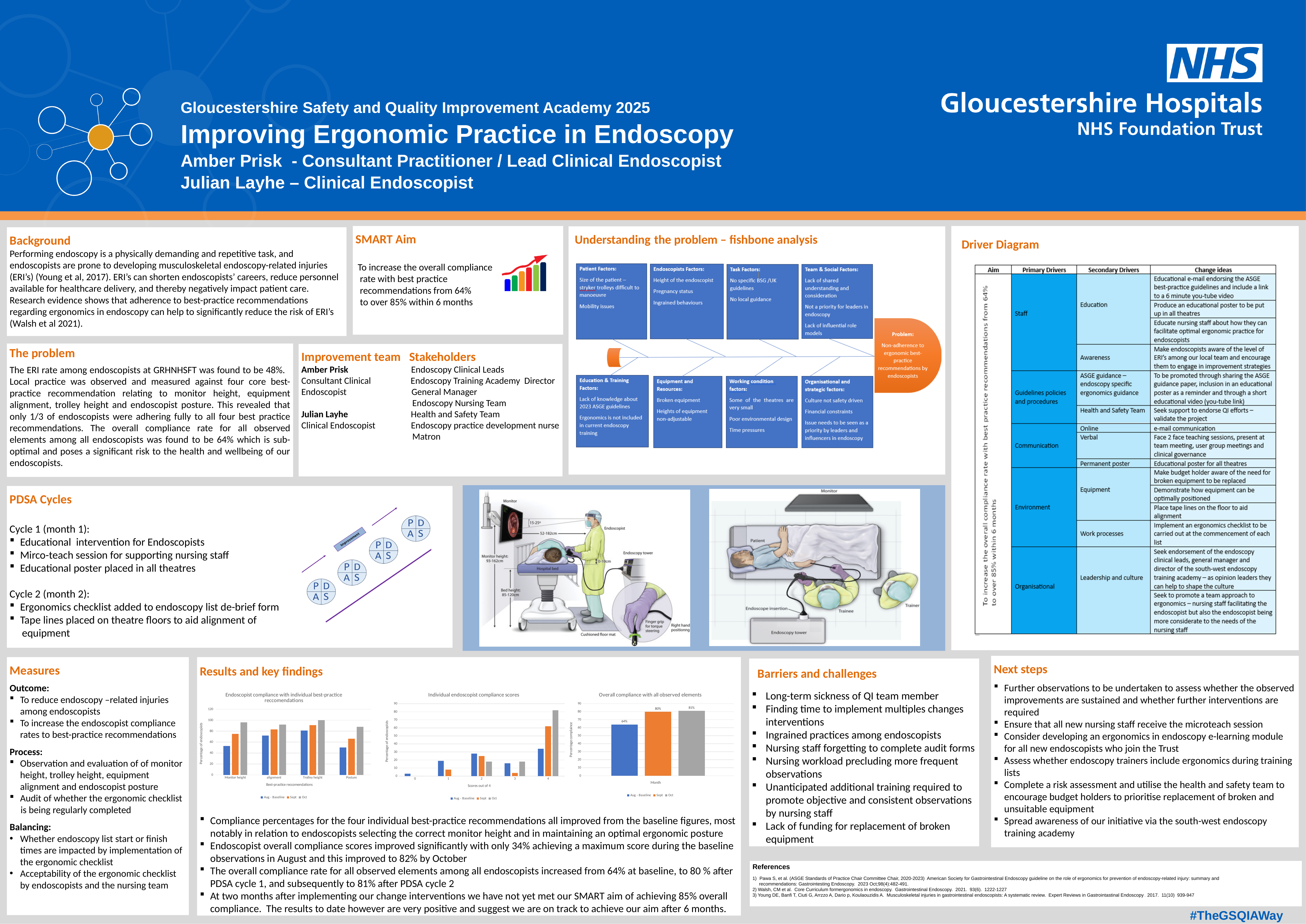
How many series does the legend list on the 'Endoscopist compliance with individual best-practice recommendations' chart? 3 On the 'Endoscopist compliance with individual best-practice recommendations' chart, is the Oct value for Trolley height greater or less than 80? greater On the 'Overall compliance with all observed elements' chart, which month has the lowest compliance? Aug - Baseline How many best-practice recommendation categories are shown on the x axis of the 'Endoscopist compliance with individual best-practice recommendations' chart? 4 On the 'Overall compliance with all observed elements' chart, do the values rise or fall from Aug - Baseline to Oct? rise On the 'Overall compliance with all observed elements' chart, what is the value for Oct? 81% On the 'Overall compliance with all observed elements' chart, what is the difference between the Sept value and the Aug - Baseline value? 16% On the 'Endoscopist compliance with individual best-practice recommendations' chart, which is larger for Aug - Baseline: Monitor height or Trolley height? Trolley height On the 'Overall compliance with all observed elements' chart, what is the value for Aug - Baseline? 64% On the 'Endoscopist compliance with individual best-practice recommendations' chart, is the Aug - Baseline value for Monitor height greater or less than 60? less On the 'Individual endoscopist compliance scores' chart, is the Oct value for a score of 4 greater or less than 70? greater What kind of chart is 'Individual endoscopist compliance scores'? bar chart